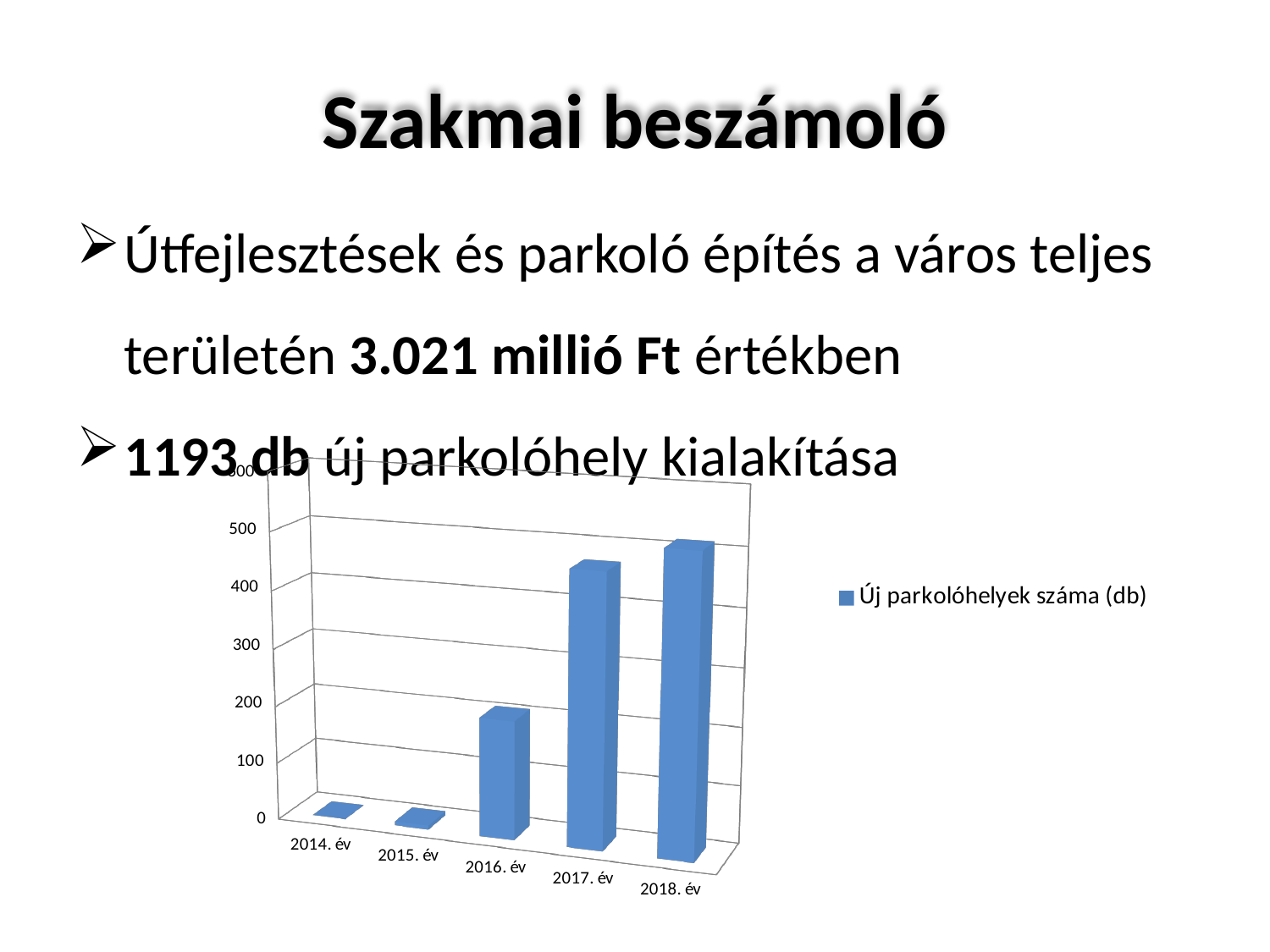
What is the name of the series shown in the chart's legend? Új parkolóhelyek száma (db) How many series does the chart's legend list? 1 Is the value for 2014. év greater or less than 100? less What kind of chart is shown on the slide? bar chart Do the values in the chart generally rise or fall from 2014. év to 2018. év? rise Is the value for 2017. év greater or less than 400? greater Which year has the highest number of new parking spaces in the chart? 2018. év Which is larger, the value for 2016. év or the value for 2017. év? 2017. év What is the first year label on the x axis of the chart? 2014. év How many categories (years) are shown on the x axis of the chart? 5